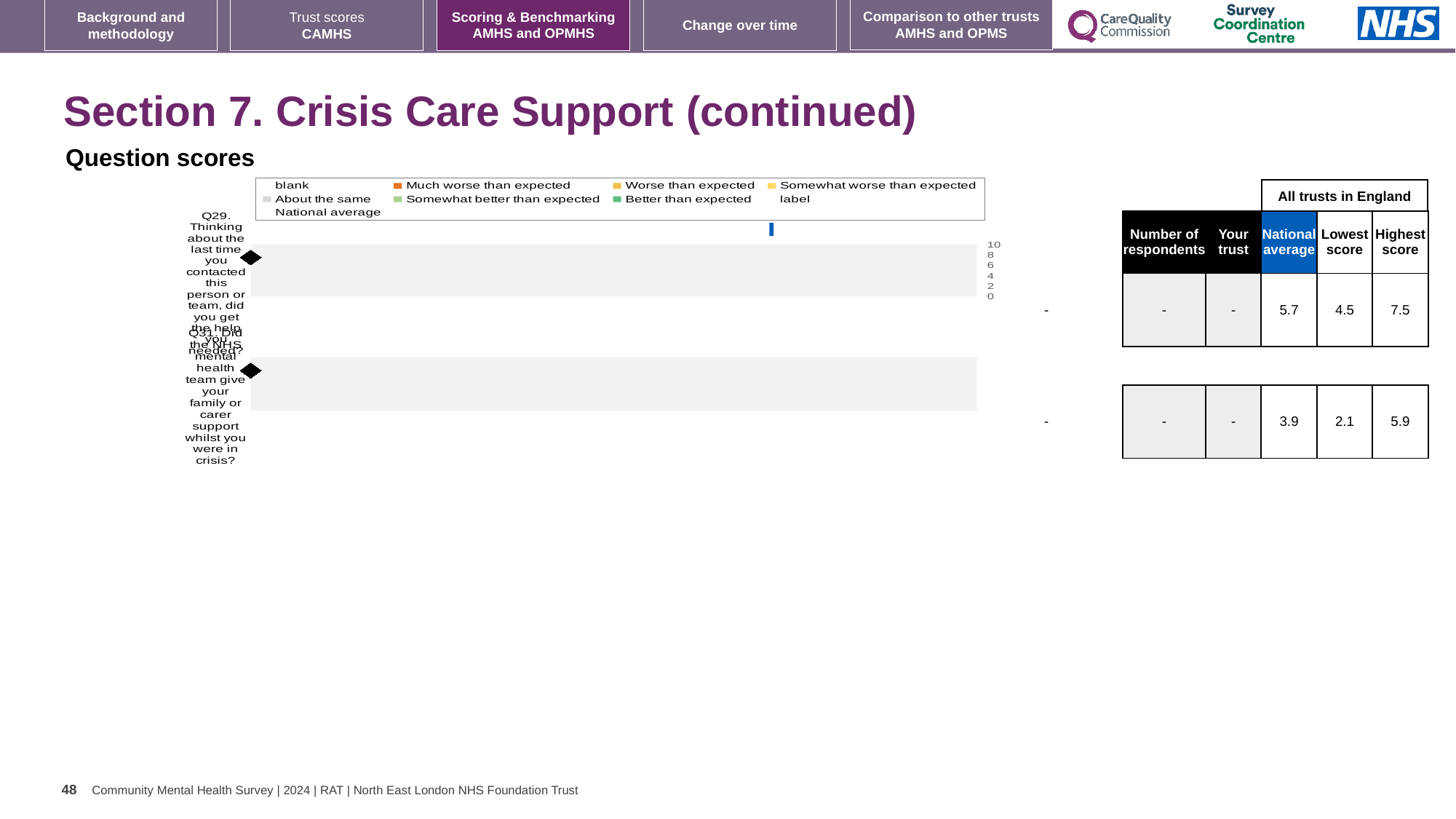
In the table next to the chart, what is the lowest score across all trusts in England for Q31? 2.1 In the table next to the chart, what is the national average score for Q31? 3.9 What kind of chart is shown under 'Question scores'? bar chart What is the difference between the national averages of Q29 and Q31 in the table? 1.8 Which question has the higher national average in the table, Q29 or Q31? Q29 How many questions (categories) are listed on the chart's vertical axis? 2 What is the highest tick value shown on the chart's horizontal axis? 10 What value is shown for 'Your trust' for Q29 in the table? - What is the difference between the highest and lowest scores for Q29 in the table? 3.0 Which legend entry is shown in orange? Much worse than expected In the table next to the chart, what is the highest score across all trusts in England for Q29? 7.5 In the table next to the chart, what is the national average score for Q29? 5.7